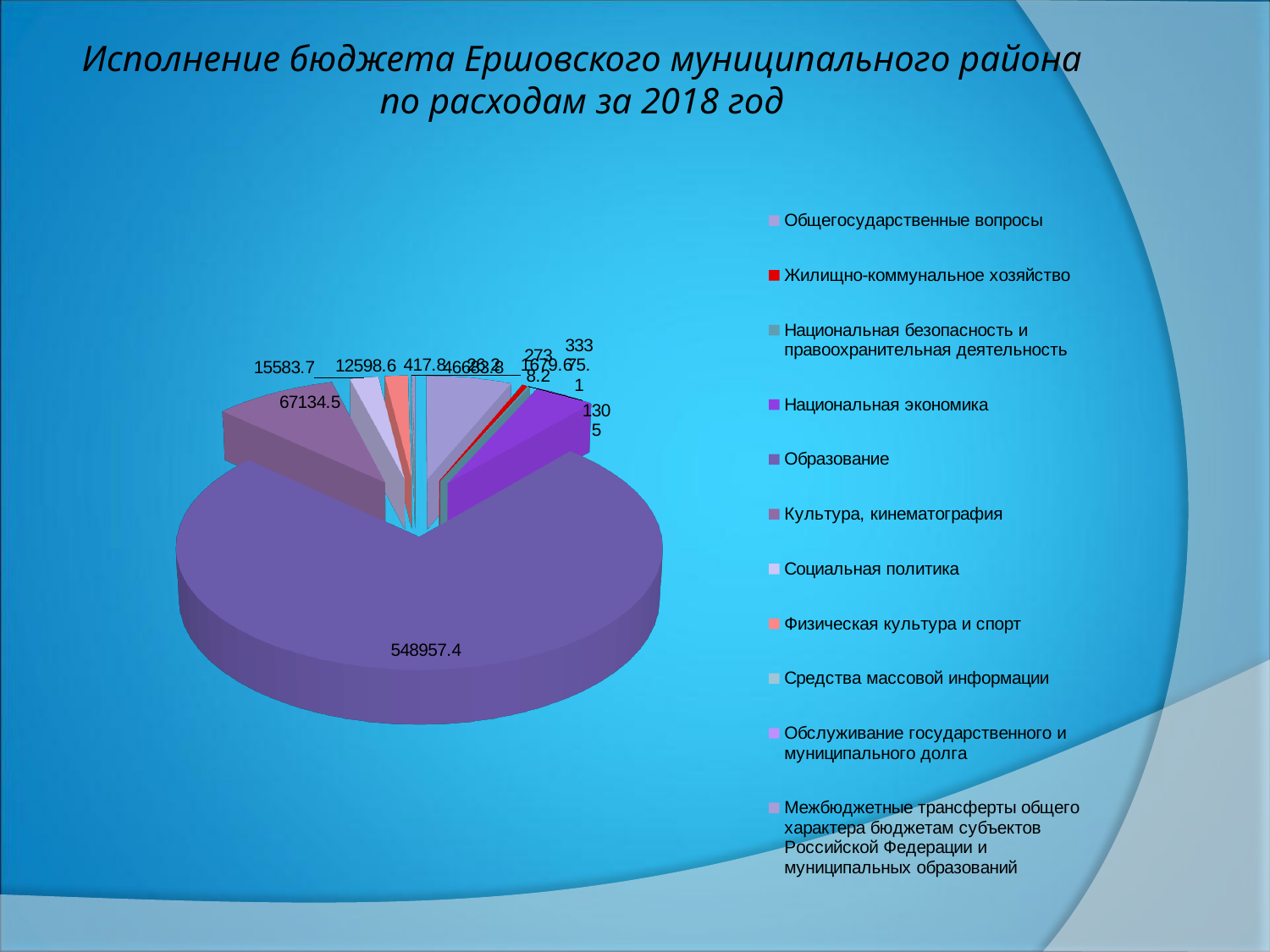
Which category is listed first in the legend of the pie chart? Общегосударственные вопросы Which is larger in the pie chart: Образование or Культура, кинематография? Образование Which category has the largest slice of the pie chart? Образование What kind of chart is shown on the slide? pie chart What is the value shown on the largest slice of the pie chart? 548957.4 What is the title of the chart on the slide? Исполнение бюджета Ершовского муниципального района по расходам за 2018 год What is the difference between the values for Образование and Культура, кинематография? 481822.9 How many categories does the legend of the pie chart list? 11 What is the value for Образование in the pie chart? 548957.4 What is the value for Культура, кинематография in the pie chart? 67134.5